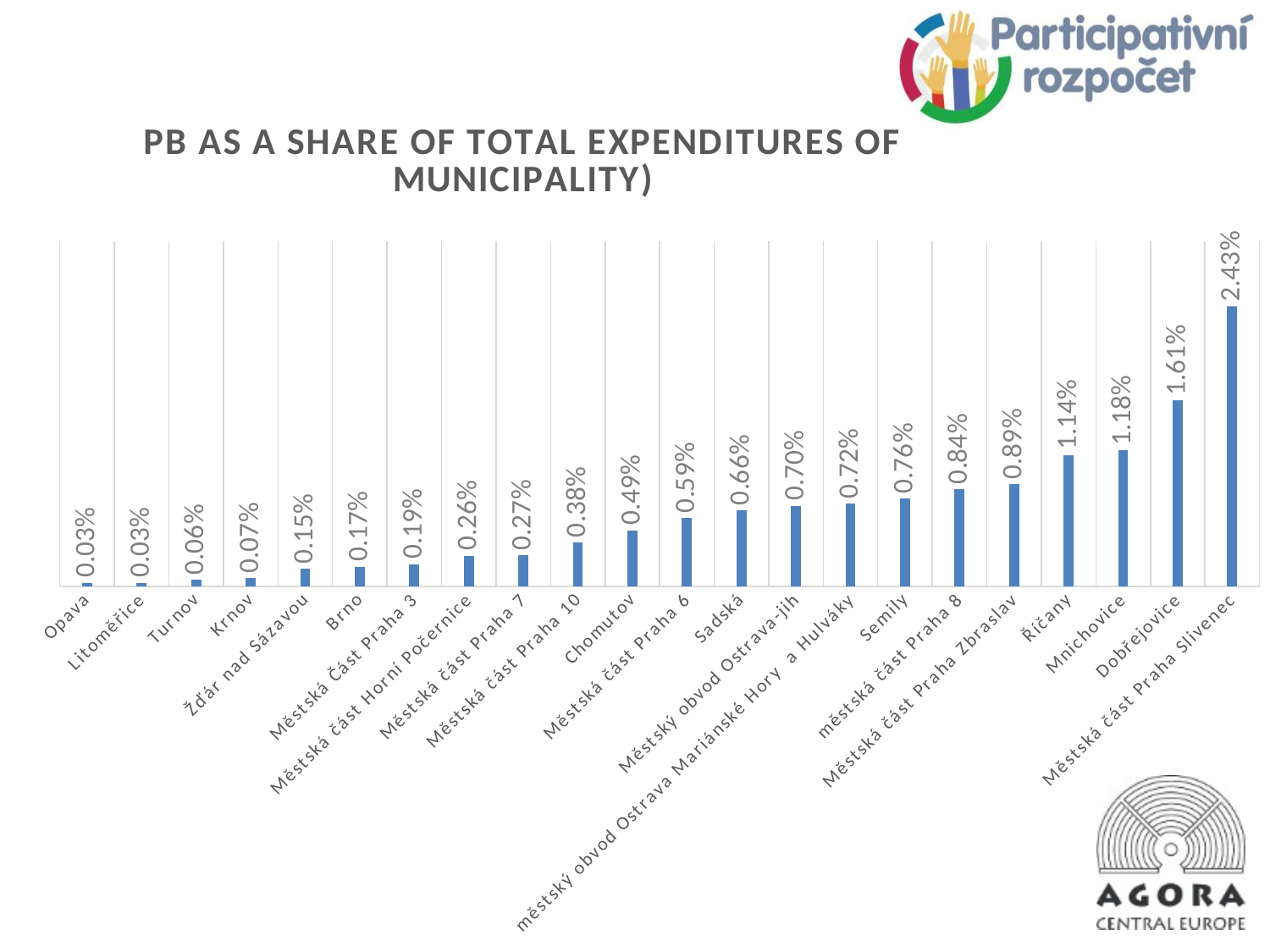
What is the value for Semily? 0.76% What is the highest value shown on the chart? 2.43% Do the values rise or fall from left to right along the x axis? Rise How many municipalities are shown on the chart? 22 What is the value for Dobřejovice? 1.61% What kind of chart is shown on the slide? Bar chart Which municipality has the highest value? Městská část Praha Slivenec What is the value for Brno? 0.17% What is the value for Chomutov? 0.49% What is the lowest value shown on the chart? 0.03% What is the difference between the values for Městská část Praha Slivenec and Dobřejovice? 0.82% Which is larger, the value for Říčany or the value for Sadská? Říčany